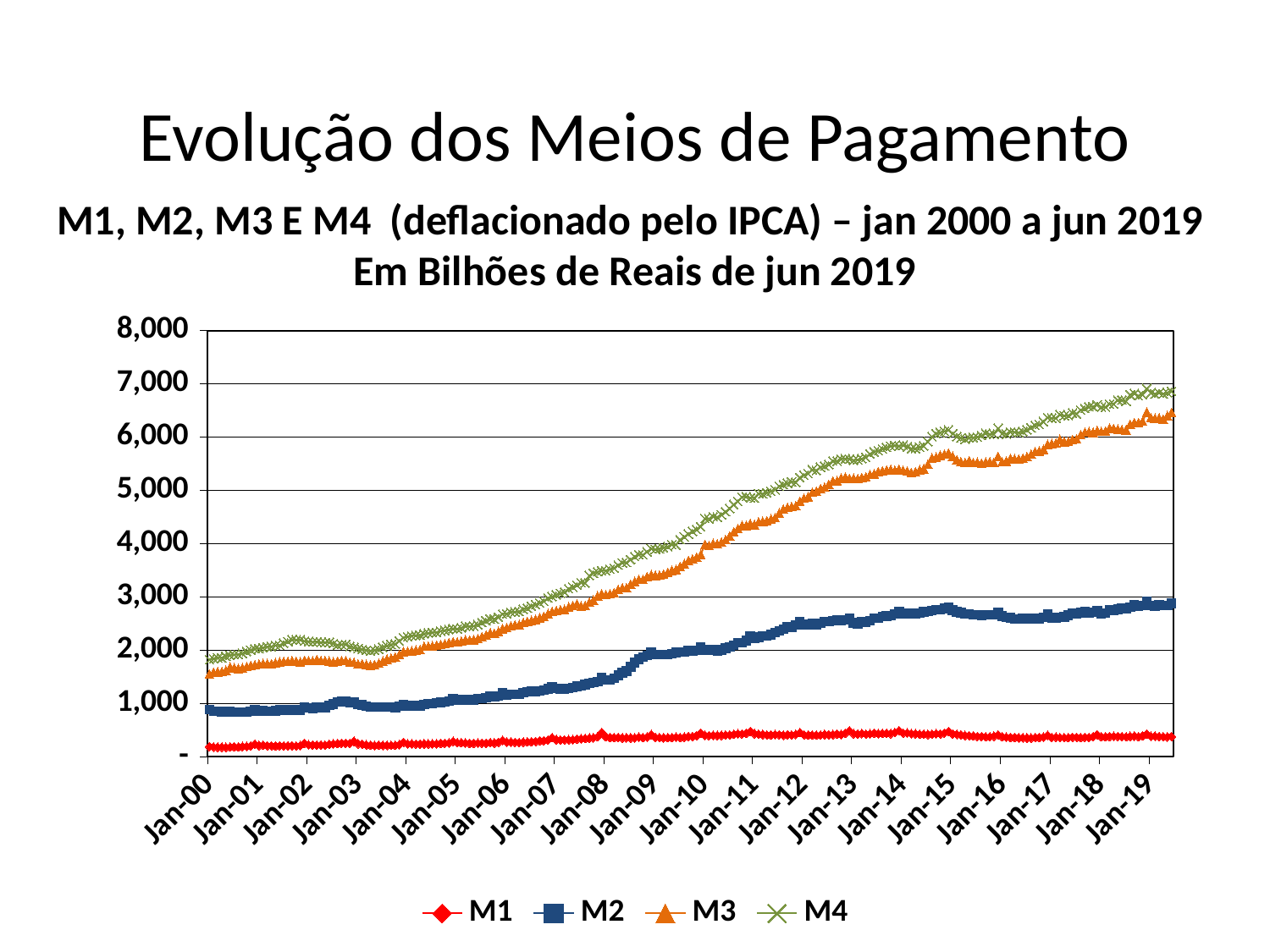
Is the value for M4 at Jan-19 greater or less than 6,000? greater At Jan-19, which is larger, M3 or M2? M3 Is the value for M1 at Jan-19 greater or less than 1,000? less Is the value for M2 at Jan-10 greater or less than 3,000? less Which series has the highest values throughout the chart? M4 What kind of chart is shown on the slide? line chart Does the M4 series rise or fall overall from Jan-00 to Jan-19? rise Which series has the lowest values throughout the chart? M1 How many series does the legend list? 4 What is the highest value shown on the vertical axis? 8,000 Which series are listed in the legend? M1, M2, M3, M4